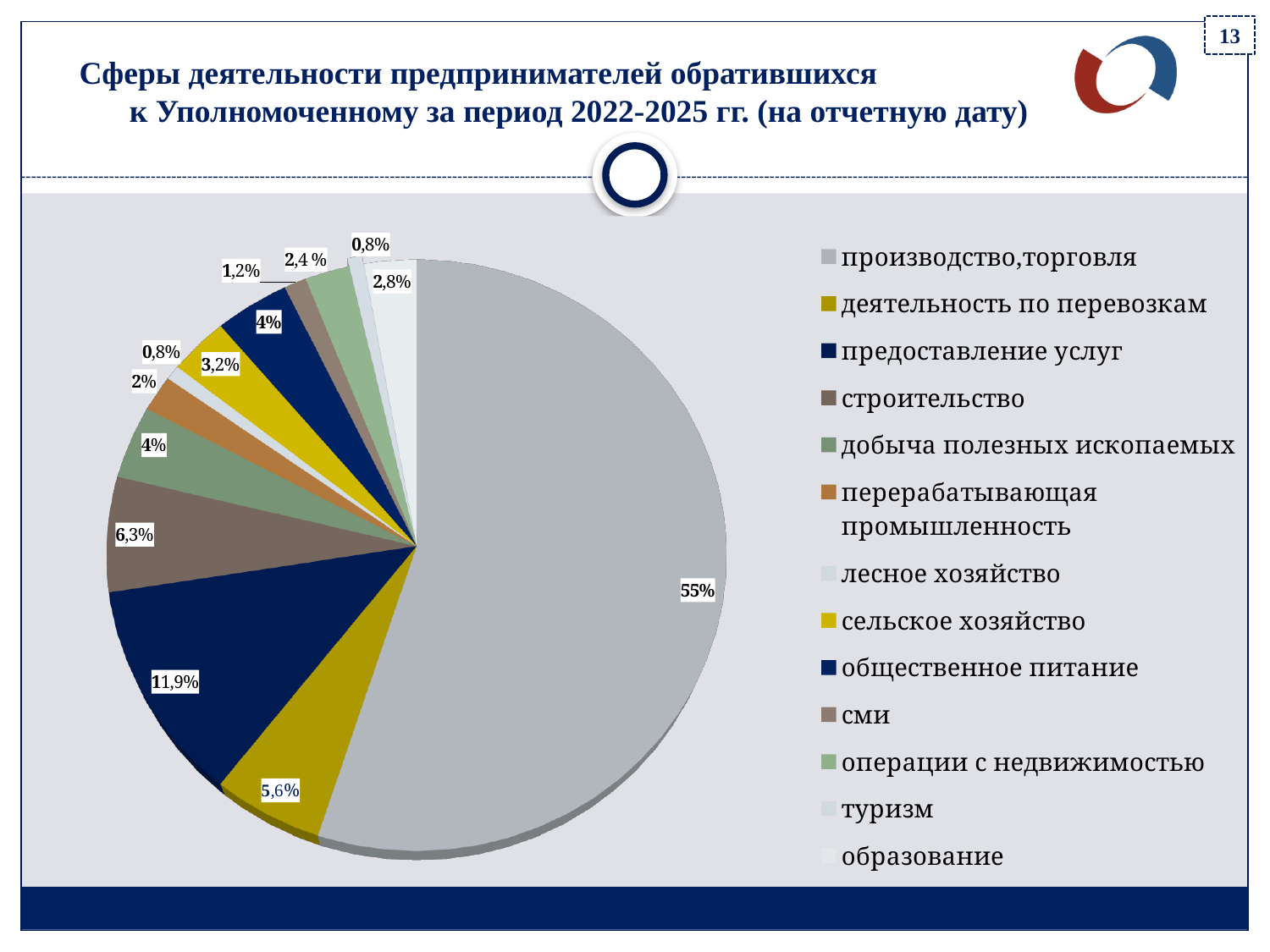
What kind of chart is shown on the slide? pie chart Which is larger, the share for предоставление услуг or the share for строительство? предоставление услуг What is the value for предоставление услуг? 11,9% What is the difference between the shares of производство,торговля and предоставление услуг? 43,1% What share of the pie does производство,торговля have? 55% Which category has the largest share of the pie? производство,торговля What is the value for деятельность по перевозкам? 5,6% What is the value for сельское хозяйство? 3,2% How many categories does the legend of the pie chart list? 13 What is the value for строительство? 6,3% What is the title of the chart on the slide? Сферы деятельности предпринимателей обратившихся к Уполномоченному за период 2022-2025 гг. (на отчетную дату) What is the value for образование? 2,8%